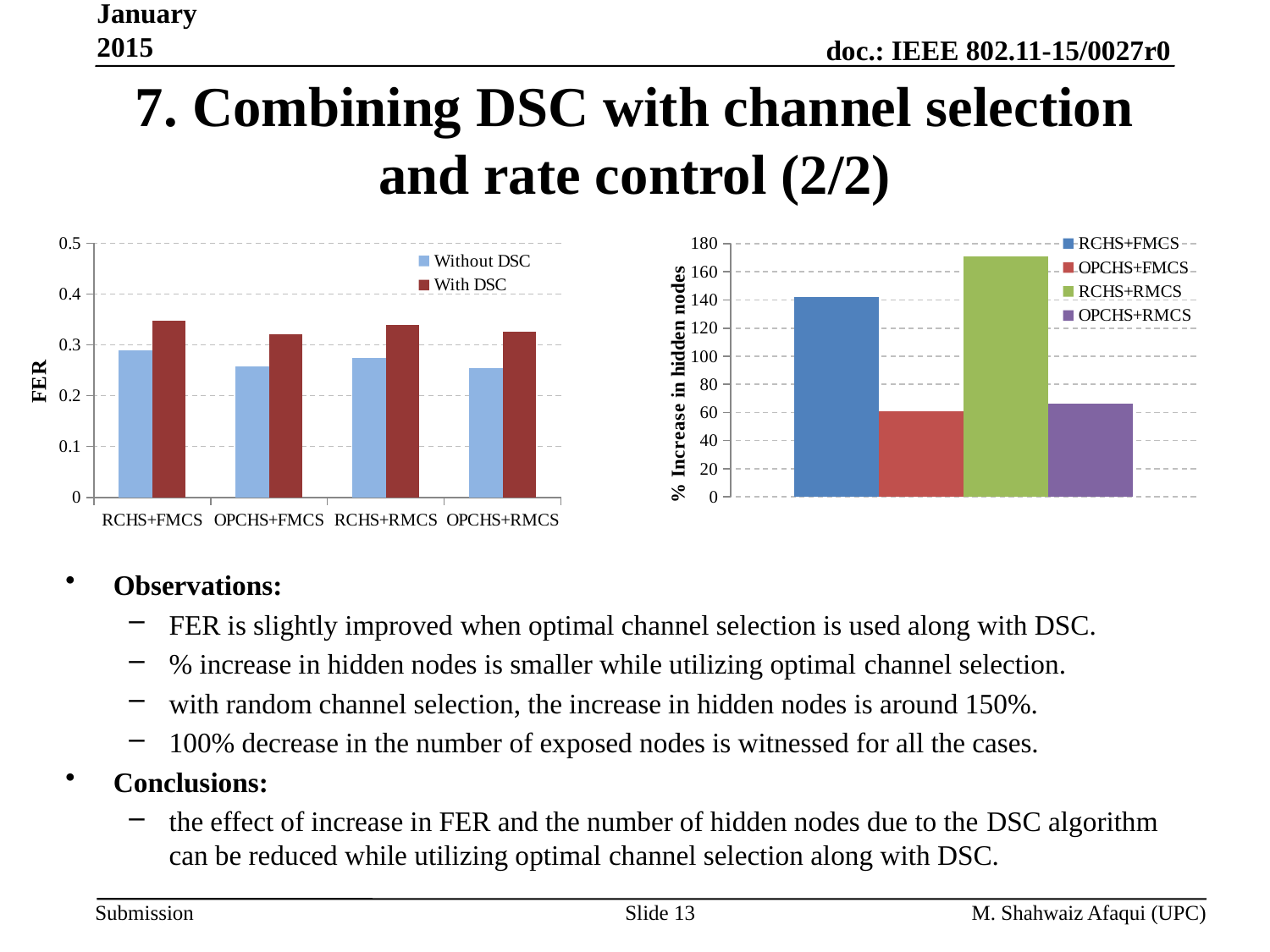
In the left FER chart, which series has the larger value for RCHS+RMCS, Without DSC or With DSC? With DSC How many categories are shown on the x axis of the left FER chart? 4 In the left FER chart, is the With DSC value for RCHS+FMCS greater or less than 0.3? greater In the right chart (% Increase in hidden nodes), is the value for RCHS+FMCS greater or less than 120? greater How many series does the legend of the left FER chart list? 2 In the right chart (% Increase in hidden nodes), which series has the lowest value? OPCHS+FMCS In the left FER chart, is the Without DSC value for OPCHS+RMCS greater or less than 0.3? less What is the y-axis label of the right chart? % Increase in hidden nodes What kind of chart is the left chart showing FER? bar chart How many series does the legend of the right chart (% Increase in hidden nodes) list? 4 In the right chart (% Increase in hidden nodes), which series has the highest value? RCHS+RMCS In the left FER chart, which category has the highest Without DSC value? RCHS+FMCS